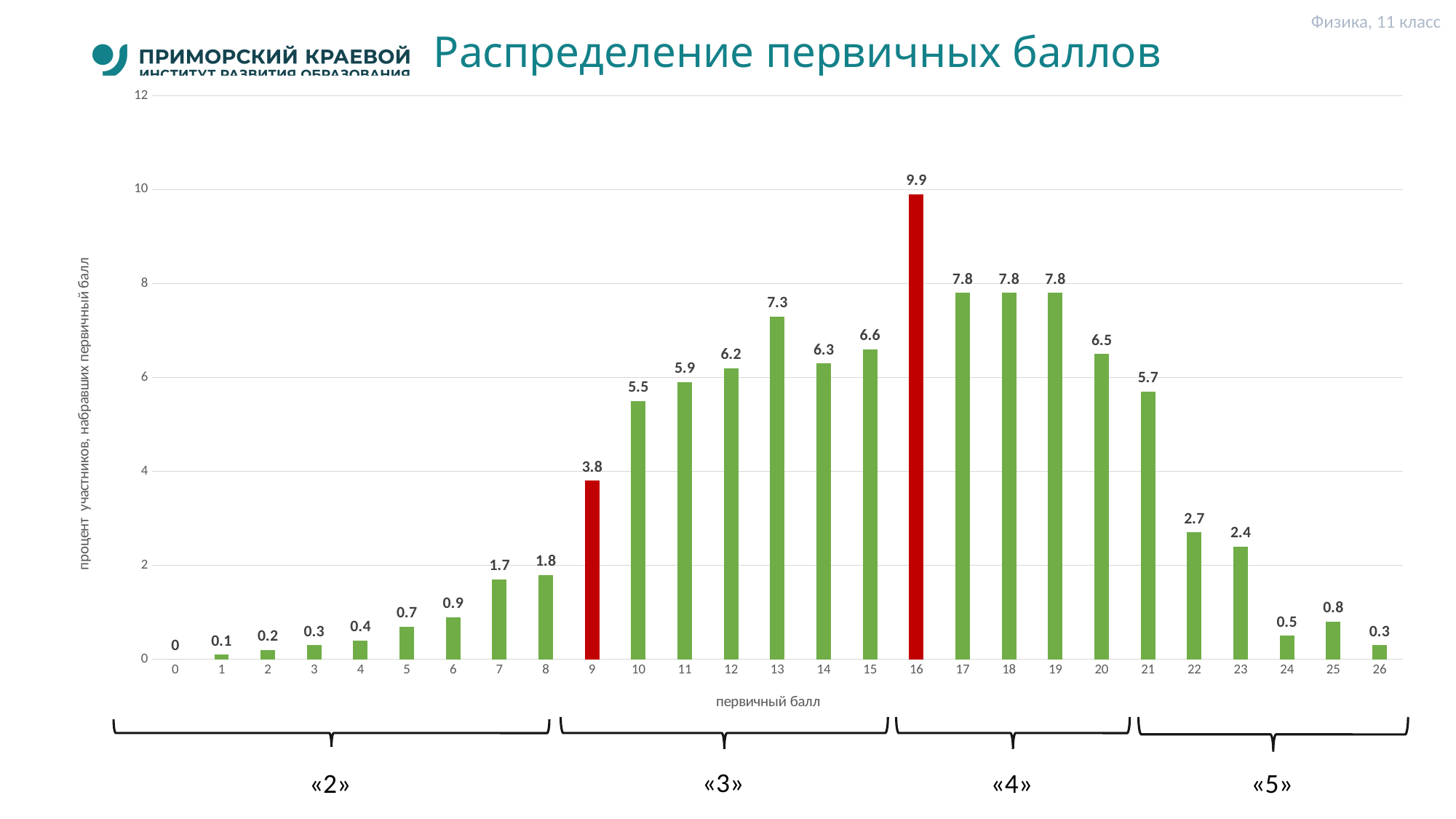
What is the value for primary score 22? 2.7 Which primary score has the highest percentage of participants? 16 Which two primary scores are shown with red bars? 9 and 16 Which primary score has the lowest percentage of participants? 0 Which has a larger value: primary score 15 or primary score 14? 15 What is the value for primary score 9? 3.8 What is the percentage of participants who scored a primary score of 16? 9.9 Do the values rise or fall along the x axis from primary score 0 to 16? rise What is the difference between the values for primary scores 16 and 13? 2.6 What type of chart is shown on the slide? bar chart How many primary score categories are shown on the x axis? 27 Is the value for primary score 21 greater or less than 4? greater